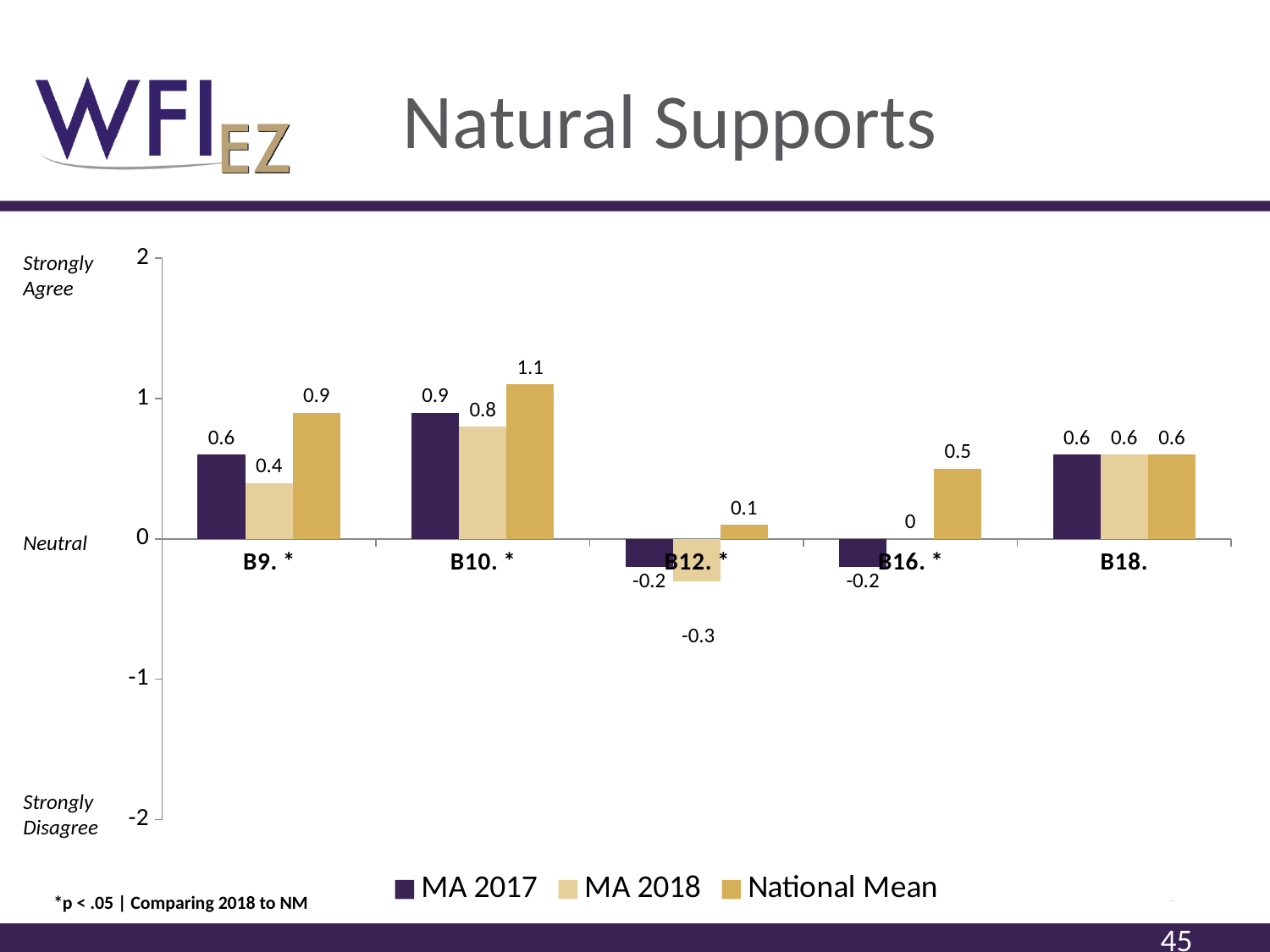
Which category has the highest National Mean value? B10. * Which is larger for B9. *, the MA 2017 value or the National Mean value? National Mean How many series does the legend list? 3 What is the title of the slide? Natural Supports What kind of chart is shown on the slide? Bar chart What is the MA 2018 value for B16. *? 0 What is the MA 2018 value for B9. *? 0.4 How many categories are shown on the x axis? 5 What is the difference between the National Mean and MA 2018 values for B16. *? 0.5 What is the National Mean value for B10. *? 1.1 What is the MA 2017 value for B12. *? -0.2 Which category has the lowest MA 2018 value? B12. *